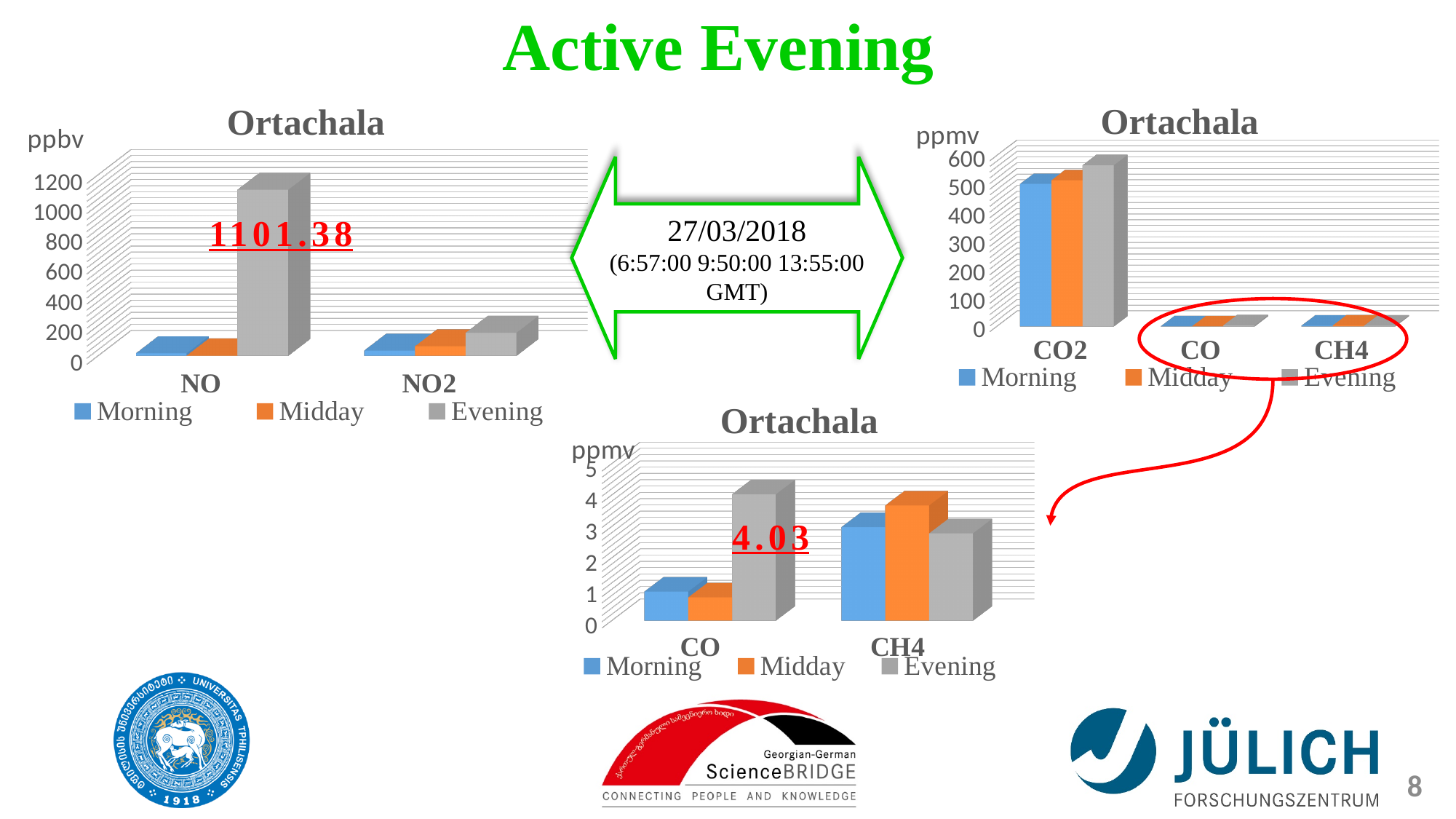
In the top-right chart, which category has the highest values? CO2 In the top-left chart (ppbv), what is the Evening value for NO? 1101.38 What unit is shown on the y axis of the top-left chart? ppbv How many series does the legend of the top-right chart list? 3 In the bottom chart, is the Morning value for CO greater or less than 2? less What kind of chart is the bottom chart? bar chart How many categories are shown on the x axis of the top-left chart? 2 In the top-right chart, is the Morning value for CO2 greater or less than 400? greater In the bottom chart (ppmv, CO and CH4), what is the Evening value for CO? 4.03 In the top-left chart, is the Evening value for NO2 greater or less than 400? less In the top-left chart, which series has the highest value for NO? Evening In the bottom chart, which series has the highest value for CH4? Midday